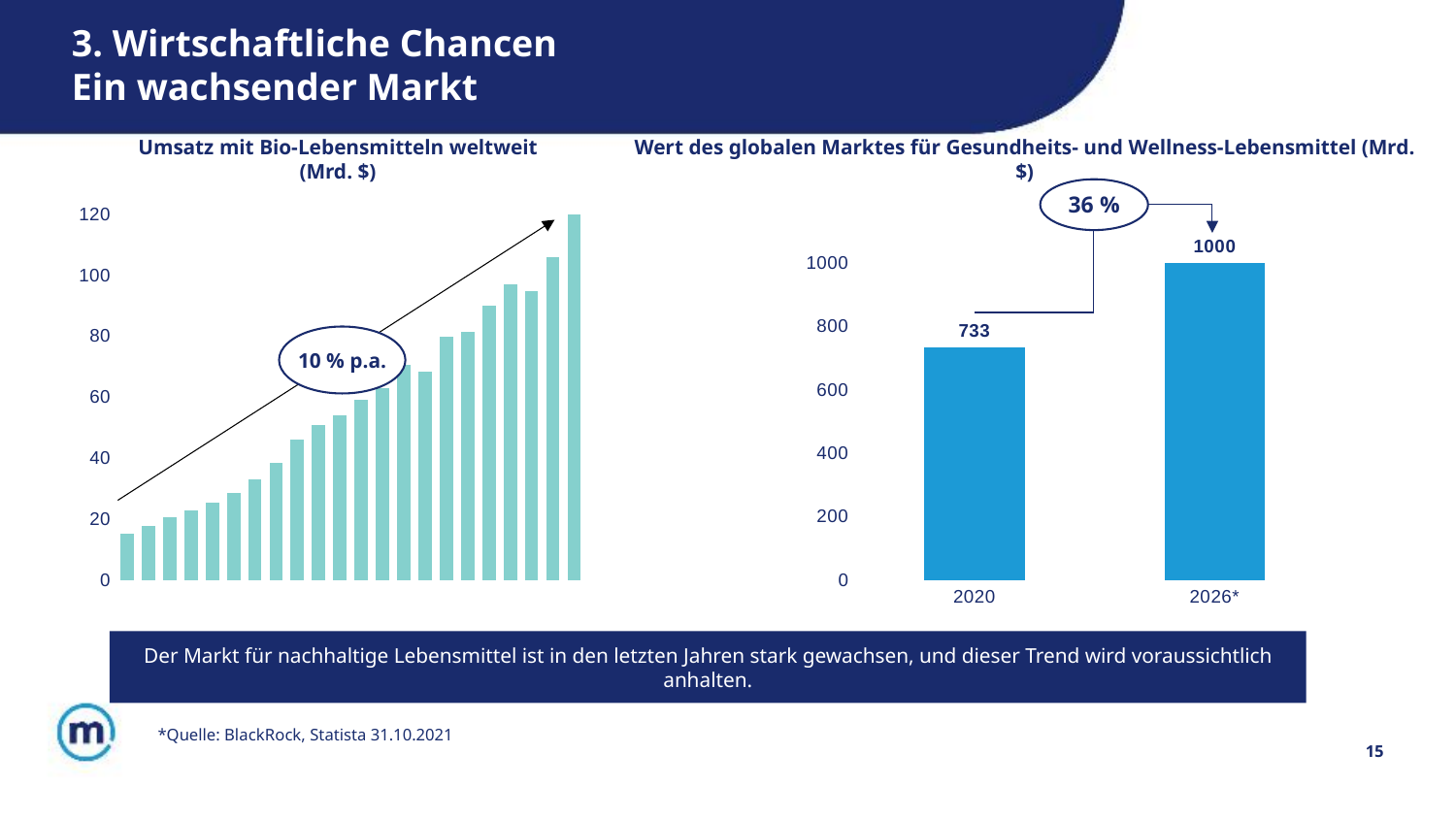
In the chart 'Wert des globalen Marktes für Gesundheits- und Wellness-Lebensmittel (Mrd. $)', what is the difference between the 2026* value and the 2020 value? 267 In the chart 'Umsatz mit Bio-Lebensmitteln weltweit (Mrd. $)', is the value of the first (leftmost) bar greater or less than 20? less In the chart 'Wert des globalen Marktes für Gesundheits- und Wellness-Lebensmittel (Mrd. $)', is the value for 2020 greater or less than 800? less In the chart 'Umsatz mit Bio-Lebensmitteln weltweit (Mrd. $)', is the value of the last (rightmost) bar greater or less than 100? greater What kind of chart is 'Umsatz mit Bio-Lebensmitteln weltweit (Mrd. $)'? bar chart In the chart 'Wert des globalen Marktes für Gesundheits- und Wellness-Lebensmittel (Mrd. $)', what percentage growth is shown in the annotation between the two bars? 36 % In the chart 'Wert des globalen Marktes für Gesundheits- und Wellness-Lebensmittel (Mrd. $)', which year has the higher value, 2020 or 2026*? 2026* In the chart 'Wert des globalen Marktes für Gesundheits- und Wellness-Lebensmittel (Mrd. $)', how many bars are shown? 2 In the chart 'Umsatz mit Bio-Lebensmitteln weltweit (Mrd. $)', do the values rise or fall along the x axis? rise In the chart 'Wert des globalen Marktes für Gesundheits- und Wellness-Lebensmittel (Mrd. $)', what is the value for 2020? 733 In the chart 'Umsatz mit Bio-Lebensmitteln weltweit (Mrd. $)', what annual growth rate is shown in the annotation? 10 % p.a. In the chart 'Wert des globalen Marktes für Gesundheits- und Wellness-Lebensmittel (Mrd. $)', what is the value for 2026*? 1000